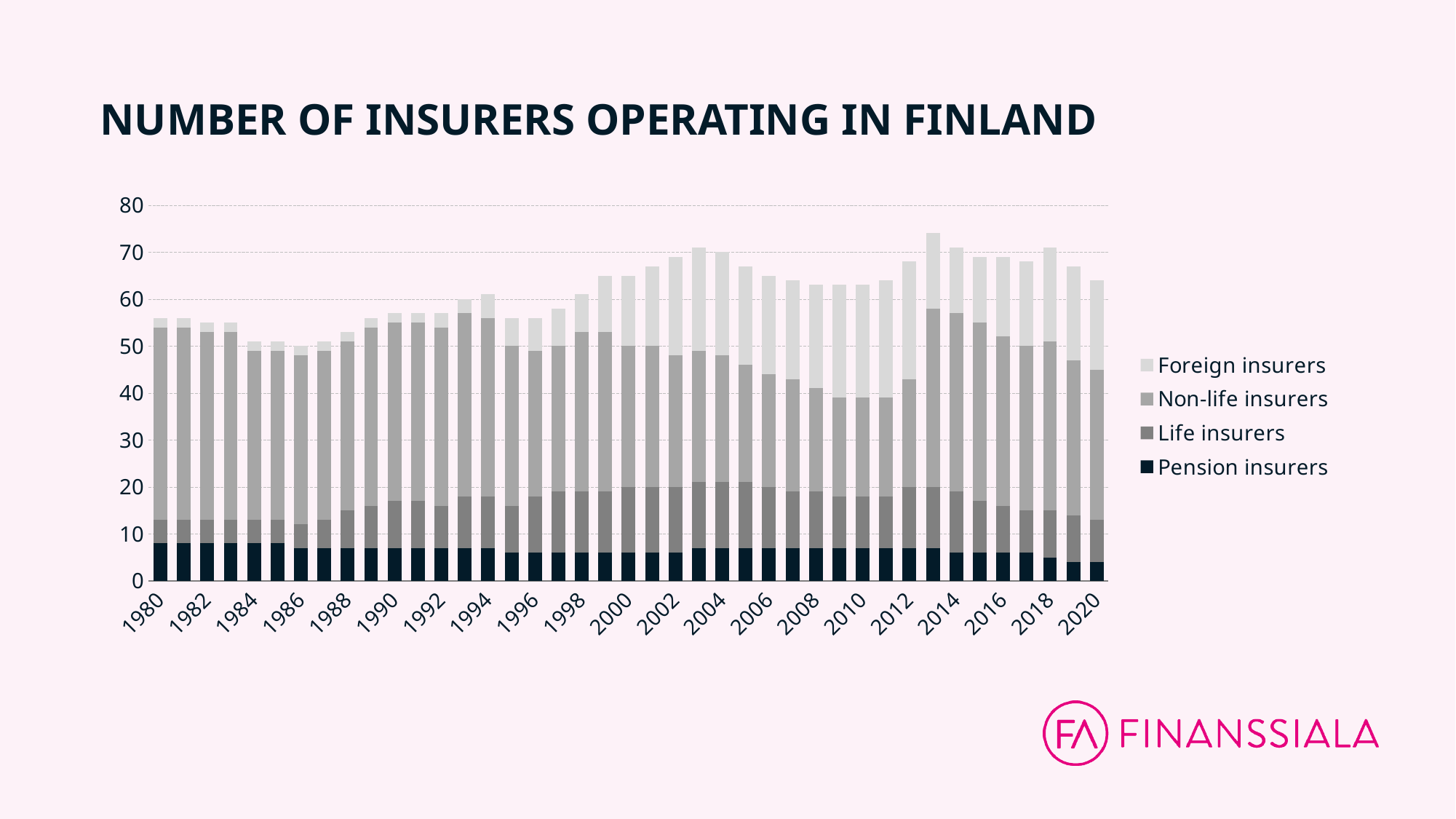
What kind of chart is shown on the slide? Stacked bar chart Is the total number of insurers in 2010 greater or less than 70? less Does the total number of insurers rise or fall from 2013 to 2020? Fall What is the title of the chart? NUMBER OF INSURERS OPERATING IN FINLAND Which series is shown in the darkest colour at the bottom of each bar? Pension insurers Is the number of pension insurers in 2020 greater or less than 10? less Is the total number of insurers in 1985 greater or less than 60? less Which year has a larger total number of insurers, 2003 or 1996? 2003 How many series does the legend list? 4 Which year has the highest total number of insurers? 2013 Does the total number of insurers rise or fall from 1987 to 2003? Rise